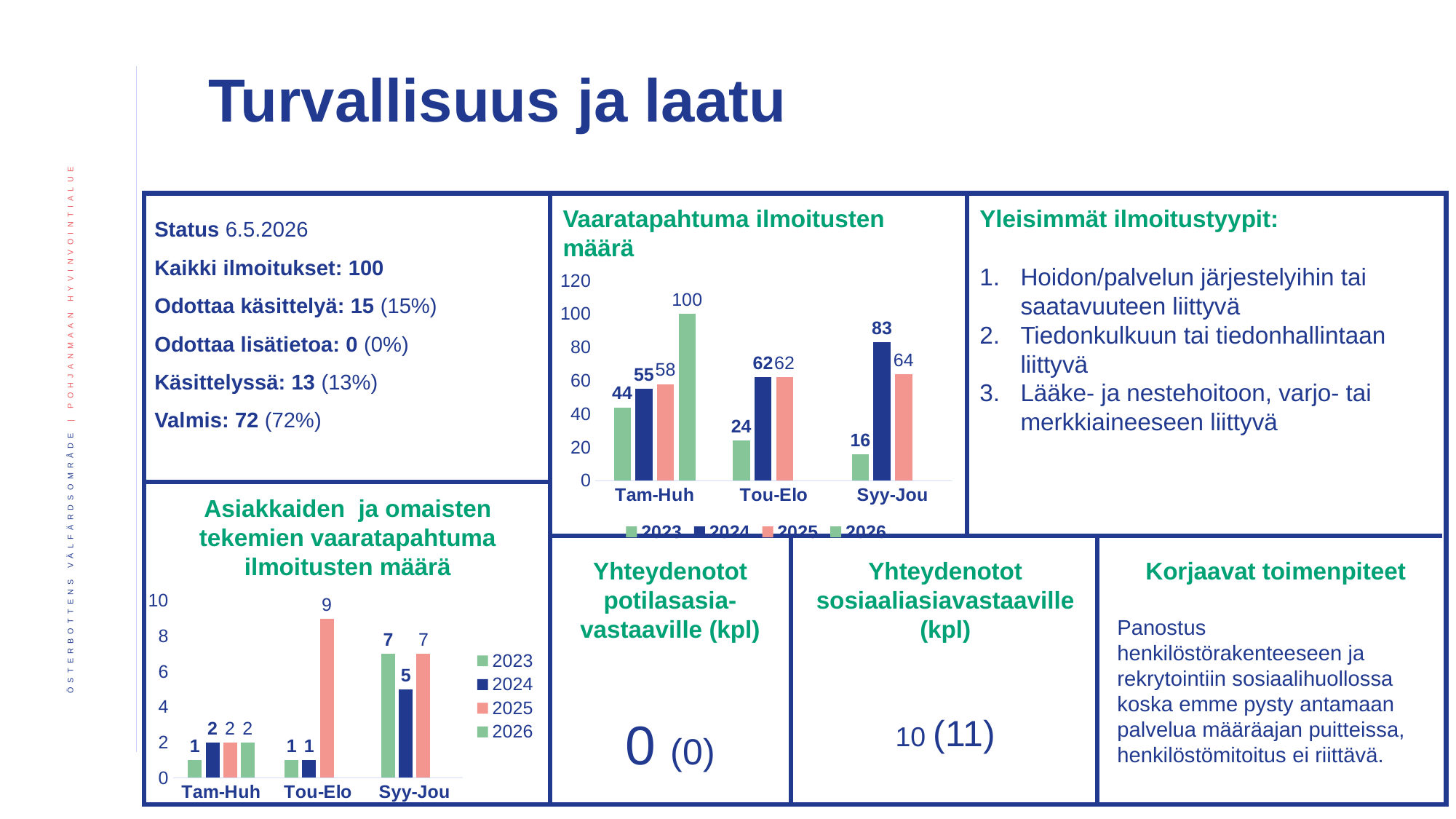
In the chart 'Vaaratapahtuma ilmoitusten määrä', what is the difference between the 2024 and 2023 values in Syy-Jou? 67 In the chart 'Vaaratapahtuma ilmoitusten määrä', what is the value for 2026 in Tam-Huh? 100 In the chart 'Vaaratapahtuma ilmoitusten määrä', what is the value for 2024 in Syy-Jou? 83 In the chart 'Asiakkaiden ja omaisten tekemien vaaratapahtuma ilmoitusten määrä', what is the difference between the 2023 and 2024 values in Syy-Jou? 2 In the chart 'Asiakkaiden ja omaisten tekemien vaaratapahtuma ilmoitusten määrä', how many periods are shown on the x axis? 3 In the chart 'Vaaratapahtuma ilmoitusten määrä', which period has the lowest value for the 2023 series? Syy-Jou In the chart 'Asiakkaiden ja omaisten tekemien vaaratapahtuma ilmoitusten määrä', which period has the highest value for the 2024 series? Syy-Jou In the chart 'Vaaratapahtuma ilmoitusten määrä', how do the 2024 values change from Tam-Huh to Syy-Jou? They rise In the chart 'Asiakkaiden ja omaisten tekemien vaaratapahtuma ilmoitusten määrä', what is the value for 2025 in Tou-Elo? 9 In the chart 'Vaaratapahtuma ilmoitusten määrä', which is larger in Tou-Elo: the 2023 value or the 2025 value? 2025 In the chart 'Vaaratapahtuma ilmoitusten määrä', how many series does the legend list? 4 What type of chart is 'Asiakkaiden ja omaisten tekemien vaaratapahtuma ilmoitusten määrä'? Bar chart